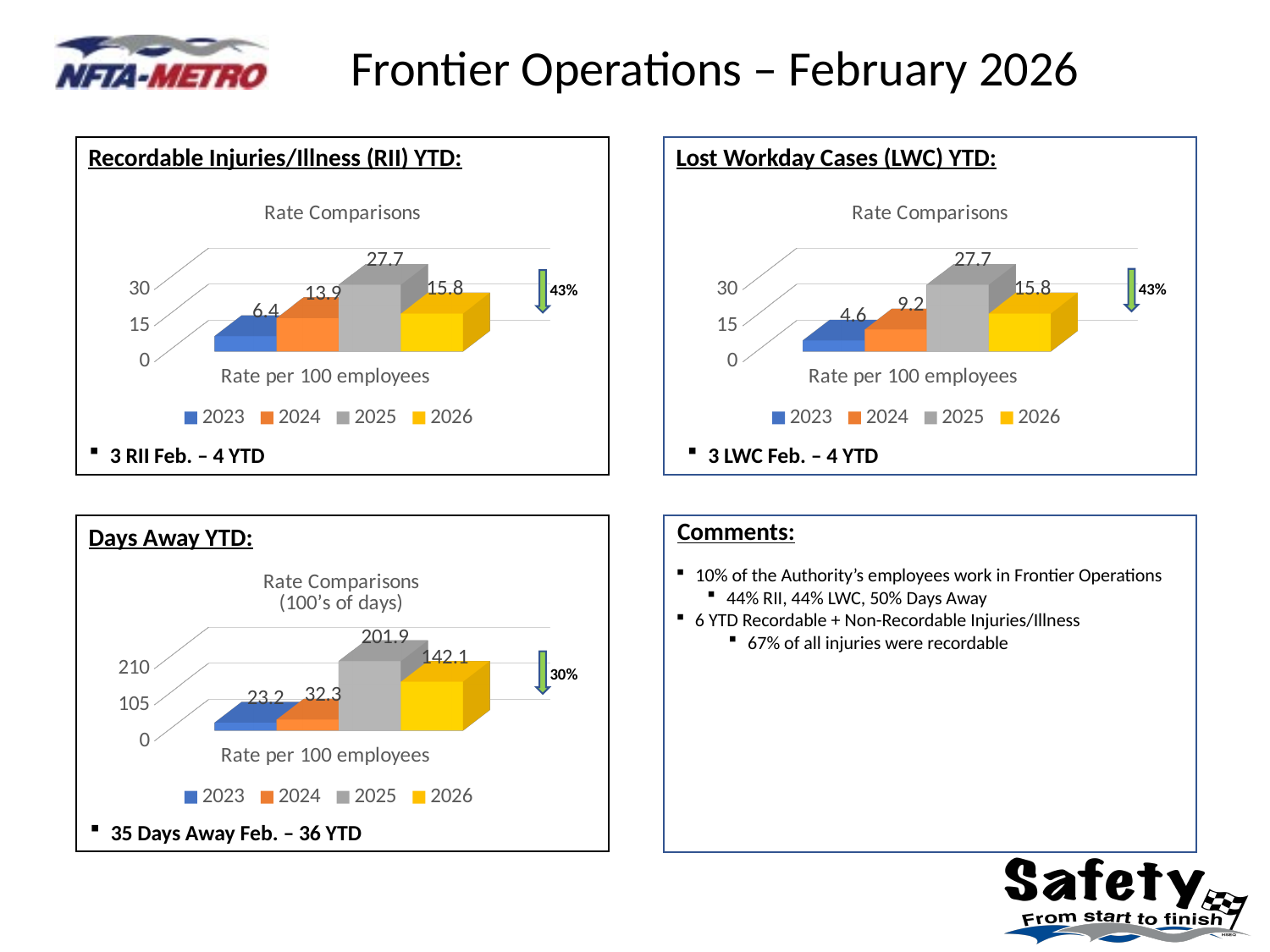
In the Days Away YTD chart, what is the value for 2026? 142.1 In the Recordable Injuries/Illness (RII) YTD chart, which year has the lowest rate? 2023 What is the x-axis label shown under the bars in the Days Away YTD chart? Rate per 100 employees In the Lost Workday Cases (LWC) YTD chart, is the value for 2023 larger or smaller than the value for 2026? smaller In the Recordable Injuries/Illness (RII) YTD chart, what is the value for 2025? 27.7 In the Days Away YTD chart, what is the difference between the 2024 and 2023 values? 9.1 In the Lost Workday Cases (LWC) YTD chart, what is the value for 2024? 9.2 In the Lost Workday Cases (LWC) YTD chart, which year has the highest rate? 2025 In the Recordable Injuries/Illness (RII) YTD chart, what is the difference between the 2025 and 2026 values? 11.9 What kind of chart is the Days Away YTD chart? bar chart How many series does the legend list in the Lost Workday Cases (LWC) YTD chart? 4 In the Recordable Injuries/Illness (RII) YTD chart, what is the value for 2023? 6.4